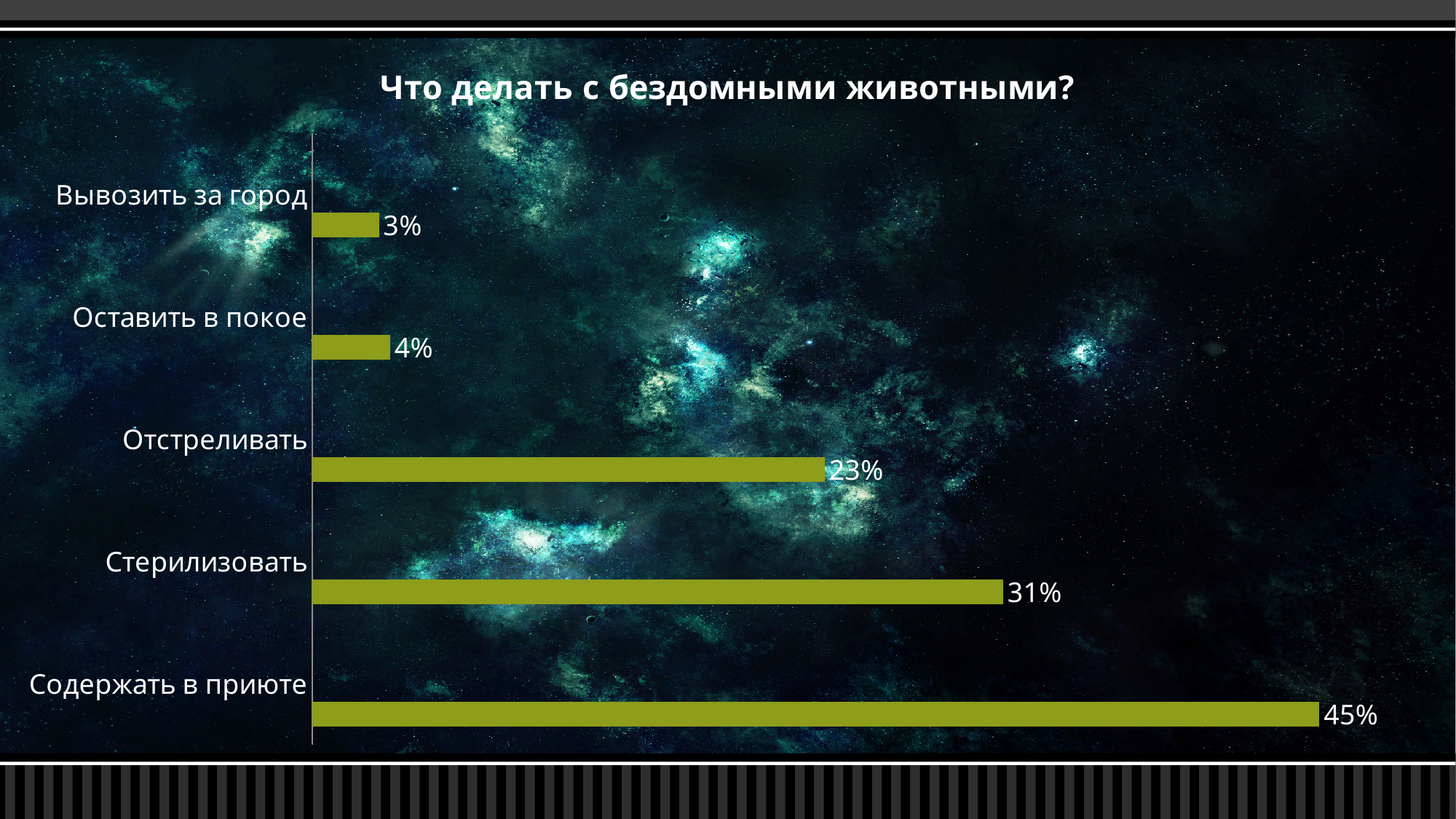
Which is larger, the value for Оставить в покое or the value for Вывозить за город? Оставить в покое What is the value for Вывозить за город? 3% How many categories are shown in the chart? 5 What colour are the bars in the chart? Olive green Which category has the highest value? Содержать в приюте What kind of chart is shown on the slide? Bar chart What is the value for Отстреливать? 23% What is the value for Содержать в приюте? 45% What is the difference between the values for Содержать в приюте and Стерилизовать? 14% What is the title of the chart? Что делать с бездомными животными? What is the difference between the values for Стерилизовать and Отстреливать? 8% Which category has the lowest value? Вывозить за город